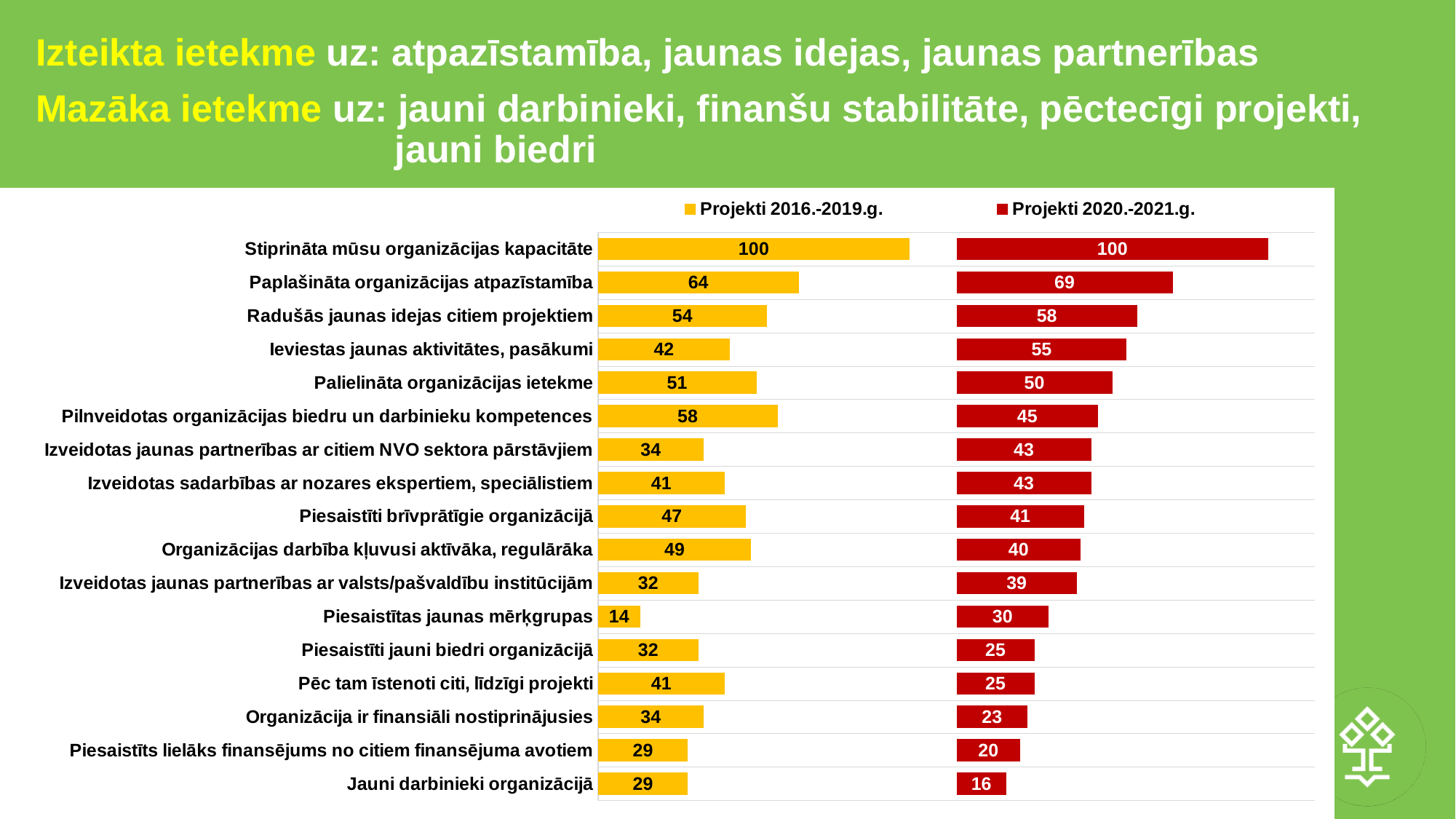
Which category has the lowest value in the Projekti 2020.-2021.g. series? Jauni darbinieki organizācijā How many categories are shown in the chart? 17 For "Pilnveidotas organizācijas biedru un darbinieku kompetences", which series has the larger value? Projekti 2016.-2019.g. What is the difference between the Projekti 2020.-2021.g. and Projekti 2016.-2019.g. values for "Piesaistītas jaunas mērķgrupas"? 16 Which category has the highest value in the Projekti 2020.-2021.g. series? Stiprināta mūsu organizācijas kapacitāte What type of chart is shown on the slide? Bar chart What is the value for "Pēc tam īstenoti citi, līdzīgi projekti" in the Projekti 2016.-2019.g. series? 41 What is the value for "Piesaistītas jaunas mērķgrupas" in the Projekti 2016.-2019.g. series? 14 Which category has the lowest value in the Projekti 2016.-2019.g. series? Piesaistītas jaunas mērķgrupas What is the value for "Ieviestas jaunas aktivitātes, pasākumi" in the Projekti 2020.-2021.g. series? 55 What is the difference between the Projekti 2016.-2019.g. and Projekti 2020.-2021.g. values for "Pēc tam īstenoti citi, līdzīgi projekti"? 16 How many series does the legend list? 2